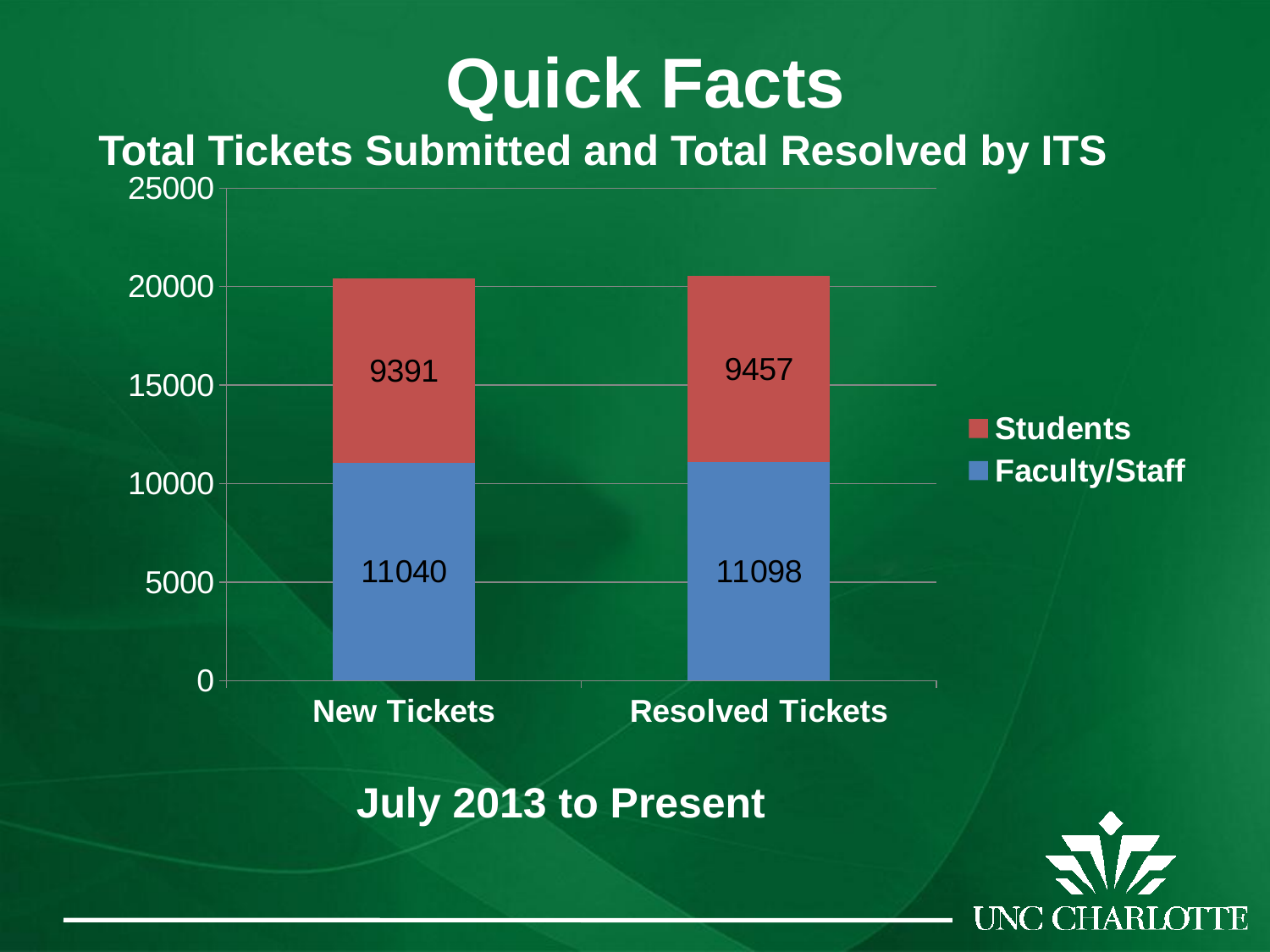
How many categories are shown on the x axis? 2 What is the value for Faculty/Staff in the Resolved Tickets bar? 11098 In the Resolved Tickets bar, which is larger: Students or Faculty/Staff? Faculty/Staff How many series does the legend list? 2 What is the total of the New Tickets stacked bar? 20431 What is the difference between the Faculty/Staff and Students values in the New Tickets bar? 1649 What is the total of the Resolved Tickets stacked bar? 20555 What kind of chart is shown on the slide? Stacked bar chart What is the value for Faculty/Staff in the New Tickets bar? 11040 What is the value for Students in the New Tickets bar? 9391 What is the value for Students in the Resolved Tickets bar? 9457 What is the difference between the Students values for Resolved Tickets and New Tickets? 66